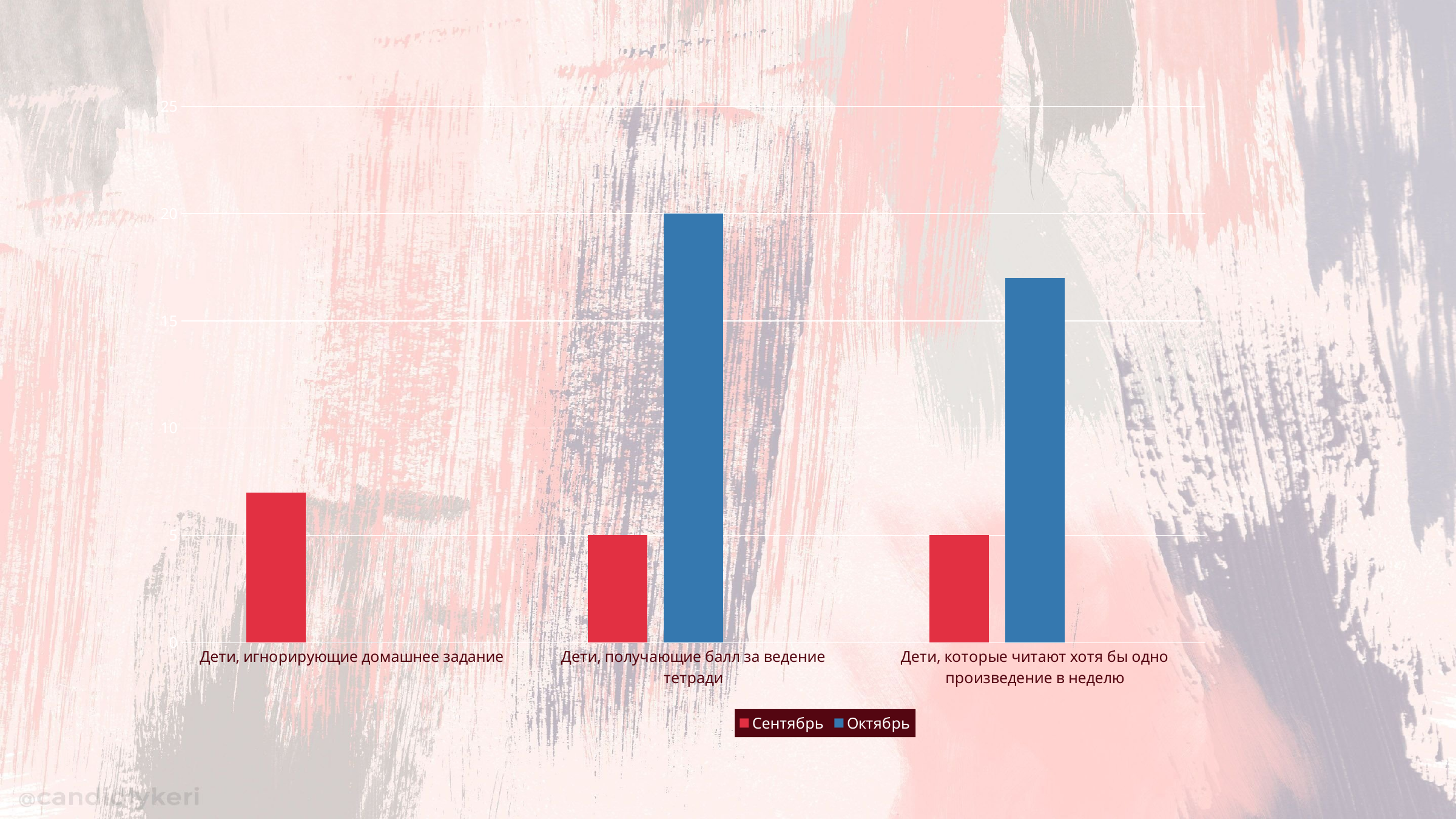
Is the Сентябрь value for "Дети, игнорирующие домашнее задание" greater or less than 10? less What are the two series named in the legend? Сентябрь, Октябрь How many categories are shown on the x axis? 3 What is the Сентябрь value for "Дети, которые читают хотя бы одно произведение в неделю"? 5 Which category has the highest Октябрь value? Дети, получающие балл за ведение тетради How many series does the legend list? 2 Which category has the highest Сентябрь value? Дети, игнорирующие домашнее задание What is the Сентябрь value for "Дети, получающие балл за ведение тетради"? 5 What kind of chart is shown on the slide? bar chart Is the Октябрь value for "Дети, которые читают хотя бы одно произведение в неделю" greater or less than 15? greater For "Дети, которые читают хотя бы одно произведение в неделю", which series has the larger value, Сентябрь or Октябрь? Октябрь What is the Октябрь value for "Дети, получающие балл за ведение тетради"? 20